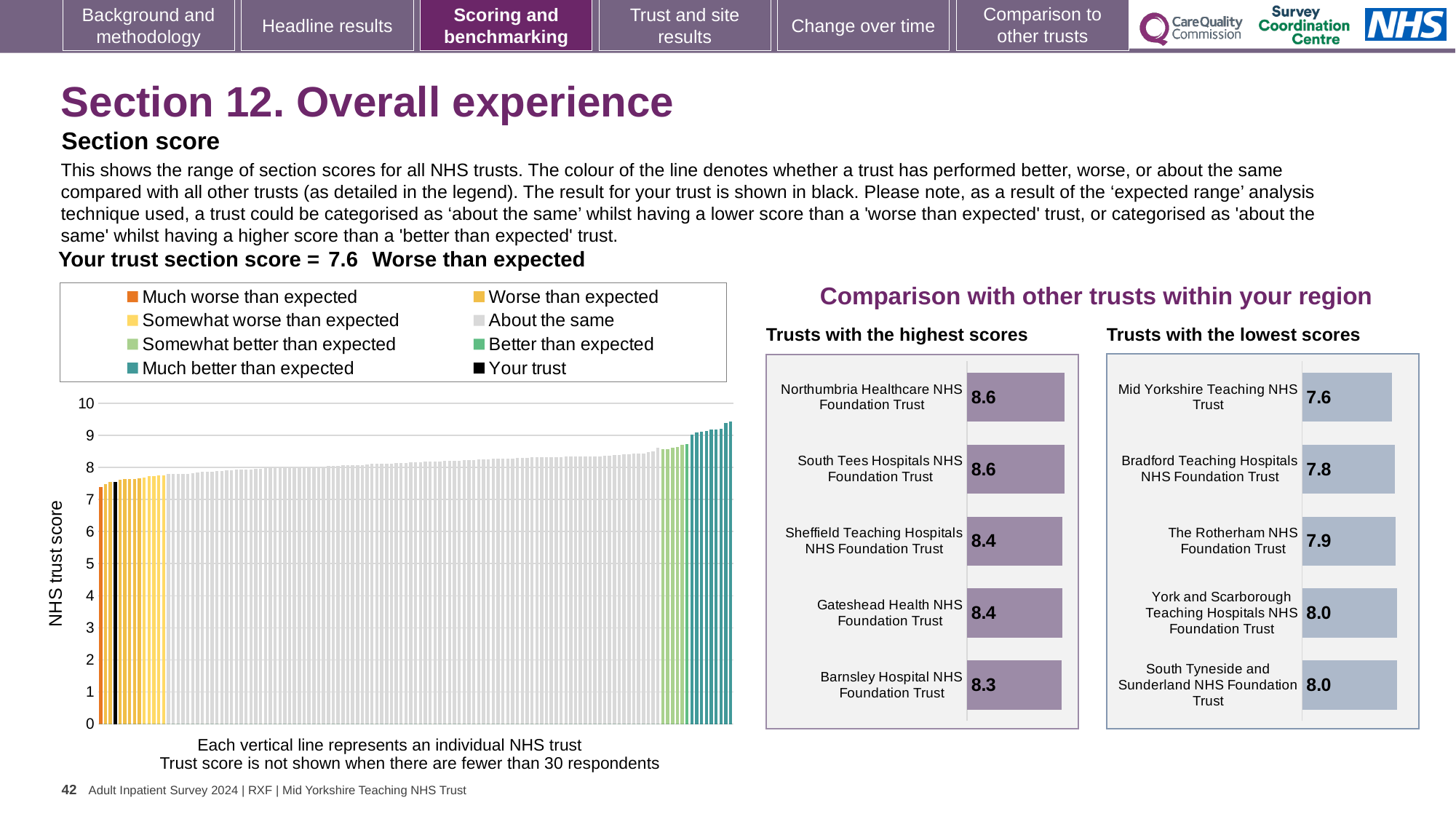
In the NHS trust score chart on the left, how many entries does the legend list? 8 In the 'Trusts with the lowest scores' chart, what is the difference between the scores for South Tyneside and Sunderland NHS Foundation Trust and Mid Yorkshire Teaching NHS Trust? 0.4 In the 'Trusts with the lowest scores' chart, what is the score for Bradford Teaching Hospitals NHS Foundation Trust? 7.8 In the 'Trusts with the highest scores' chart, how many trusts are shown? 5 In the 'Trusts with the highest scores' chart, what is the score for Barnsley Hospital NHS Foundation Trust? 8.3 In the 'Trusts with the highest scores' chart, what is the difference between the scores for Northumbria Healthcare NHS Foundation Trust and Barnsley Hospital NHS Foundation Trust? 0.3 In the 'Trusts with the lowest scores' chart, which trust has the lowest score? Mid Yorkshire Teaching NHS Trust In the 'Trusts with the highest scores' chart, what is the score for Northumbria Healthcare NHS Foundation Trust? 8.6 In the 'Trusts with the lowest scores' chart, what is the score for York and Scarborough Teaching Hospitals NHS Foundation Trust? 8.0 What kind of chart is the NHS trust score chart on the left of the slide? Bar chart In the 'Trusts with the lowest scores' chart, which is larger: the score for Bradford Teaching Hospitals NHS Foundation Trust or The Rotherham NHS Foundation Trust? The Rotherham NHS Foundation Trust In the NHS trust score chart on the left, is the value for the black 'Your trust' bar greater or less than 8? less